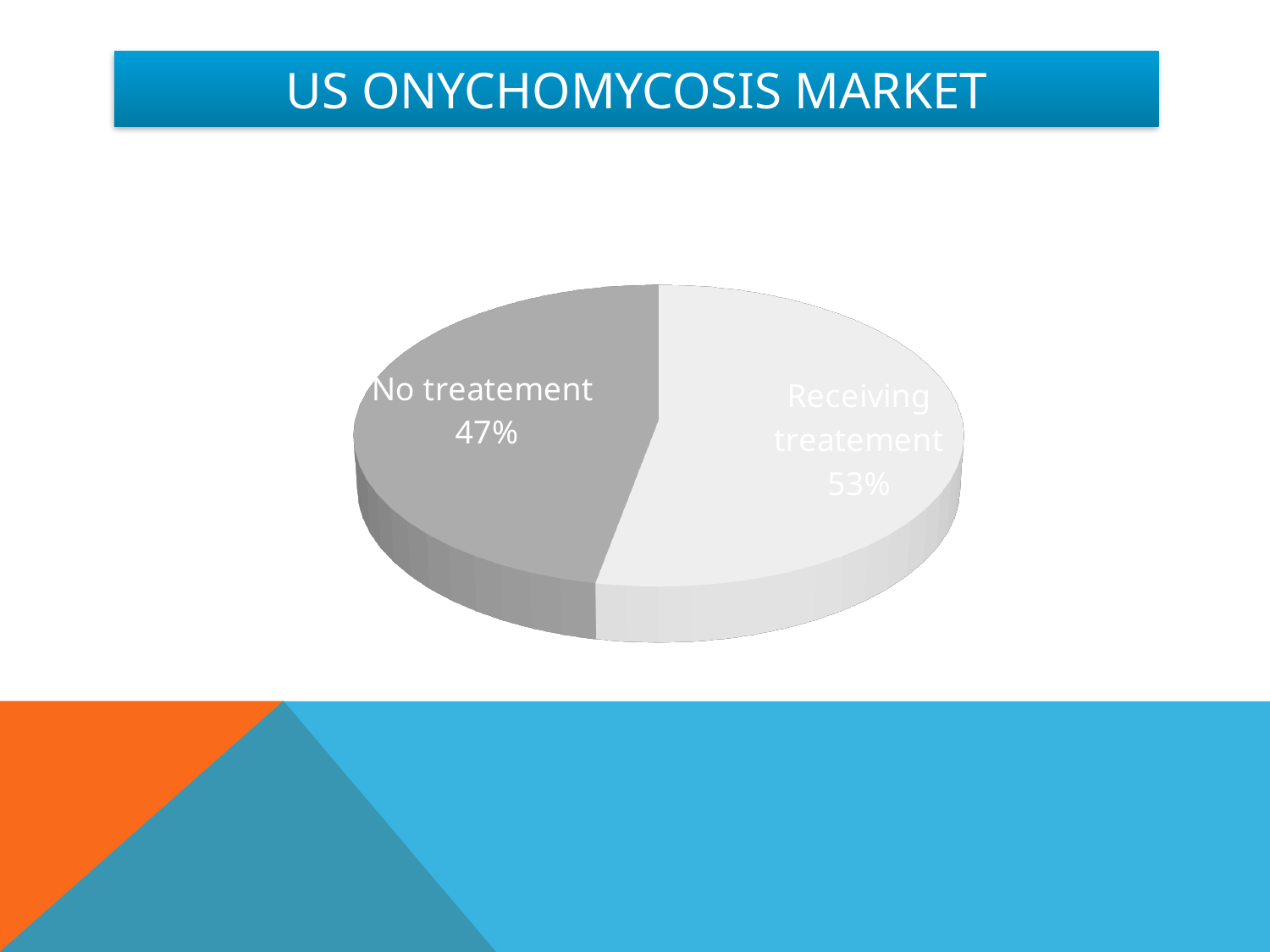
What share of the pie does the "Receiving treatement" slice represent? 53% Which slice of the pie is the smallest? No treatement What is the title of the slide containing the chart? US ONYCHOMYCOSIS MARKET How many slices does the pie chart have? 2 Which slice of the pie is the largest? Receiving treatement What share of the pie does the "No treatement" slice represent? 47% What kind of chart is shown on the slide? Pie chart What is the difference in percentage points between the "Receiving treatement" and "No treatement" slices? 6 Is the "No treatement" slice less than half of the pie? Yes Which is larger, the "No treatement" slice or the "Receiving treatement" slice? Receiving treatement